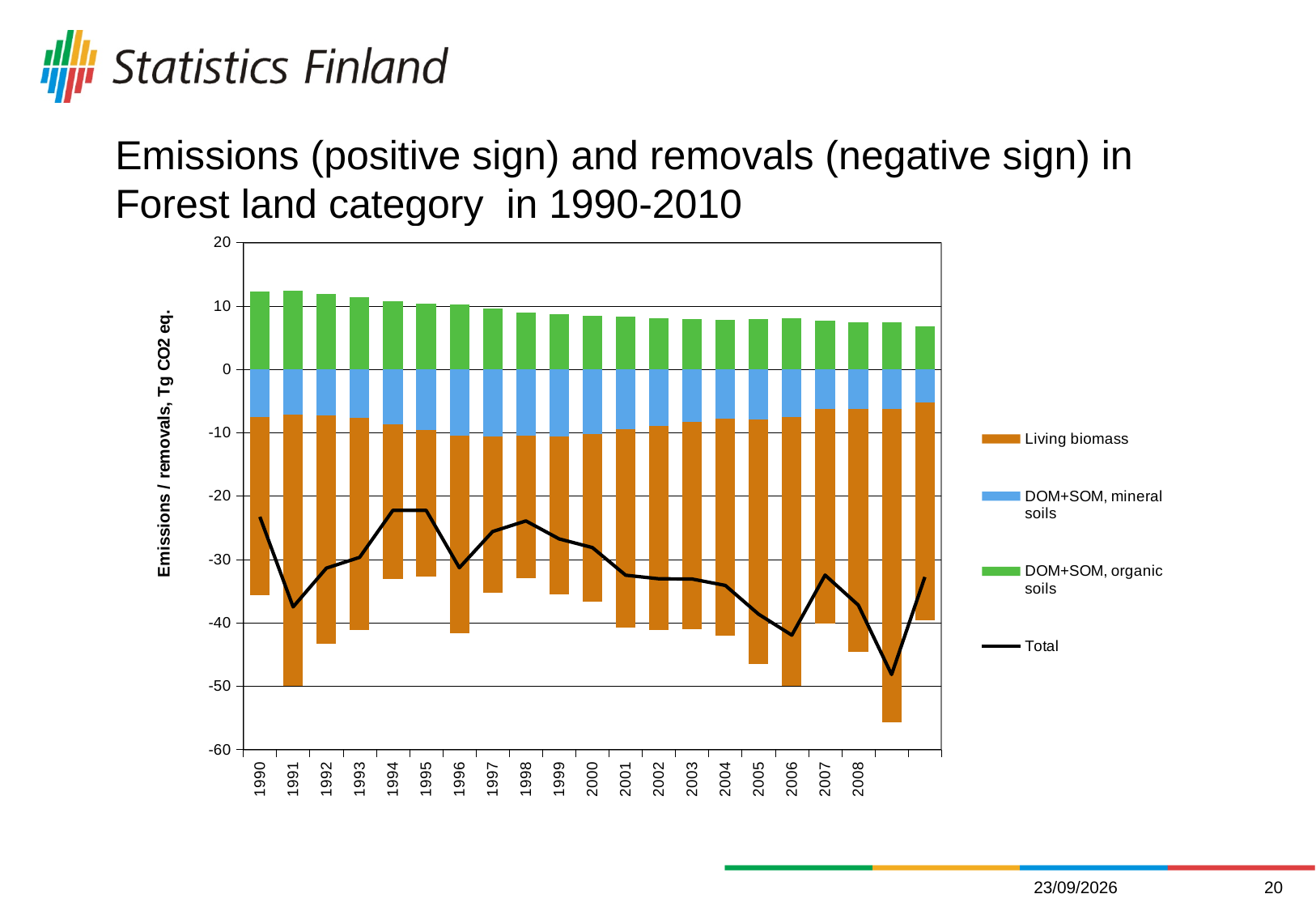
Which is larger, the DOM+SOM, organic soils value for 1990 or for 2008? 1990 What is the y-axis label of the chart? Emissions / removals, Tg CO2 eq. Is the DOM+SOM, organic soils value for 1990 greater or less than 10? greater Do the DOM+SOM, organic soils values generally rise or fall from 1990 to 2008? fall Which year has a more negative Living biomass value, 1990 or 1991? 1991 Is the Total value for 1991 greater or less than -30? less Is the DOM+SOM, mineral soils value for 1990 greater or less than -10? greater Which series is drawn as a black line? Total What kind of chart is shown on the slide? Stacked bar chart with a line How many series does the legend list? 4